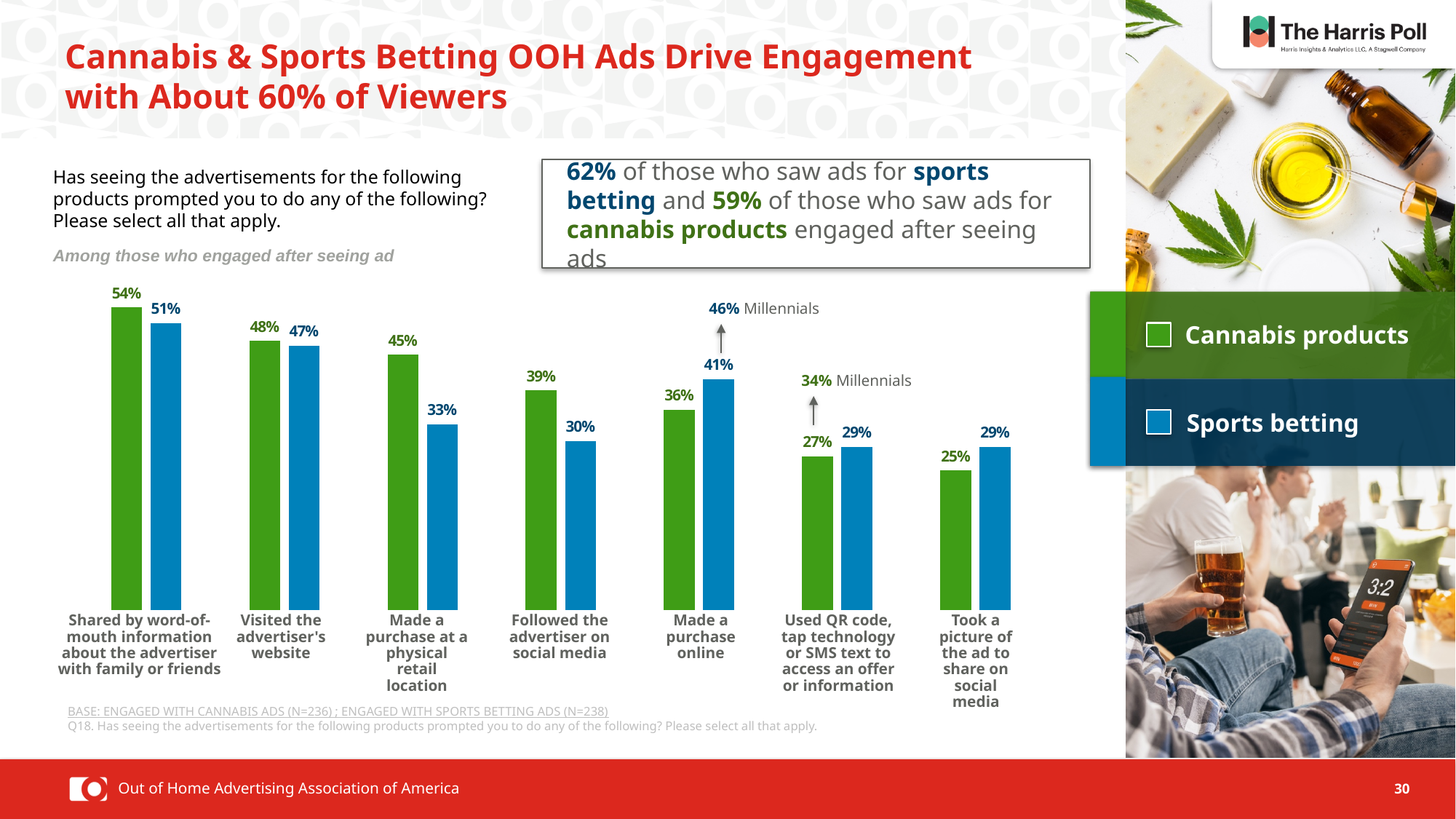
Which action has the lowest Cannabis products value? Took a picture of the ad to share on social media What percentage of Cannabis products viewers shared word-of-mouth information about the advertiser with family or friends? 54% For 'Followed the advertiser on social media', which series has the larger value, Cannabis products or Sports betting? Cannabis products What is the Cannabis products value for 'Made a purchase at a physical retail location'? 45% What is the Millennials value noted above the Sports betting bar for 'Made a purchase online'? 46% Which action has the highest Sports betting value? Shared by word-of-mouth information about the advertiser with family or friends What is the Sports betting value for 'Made a purchase online'? 41% What is the difference between the Cannabis products and Sports betting values for 'Made a purchase at a physical retail location'? 12% For 'Made a purchase online', which series has the larger value, Cannabis products or Sports betting? Sports betting What type of chart is shown on the slide? Bar chart How many series does the legend list? 2 How many action categories are shown on the x axis of the chart? 7